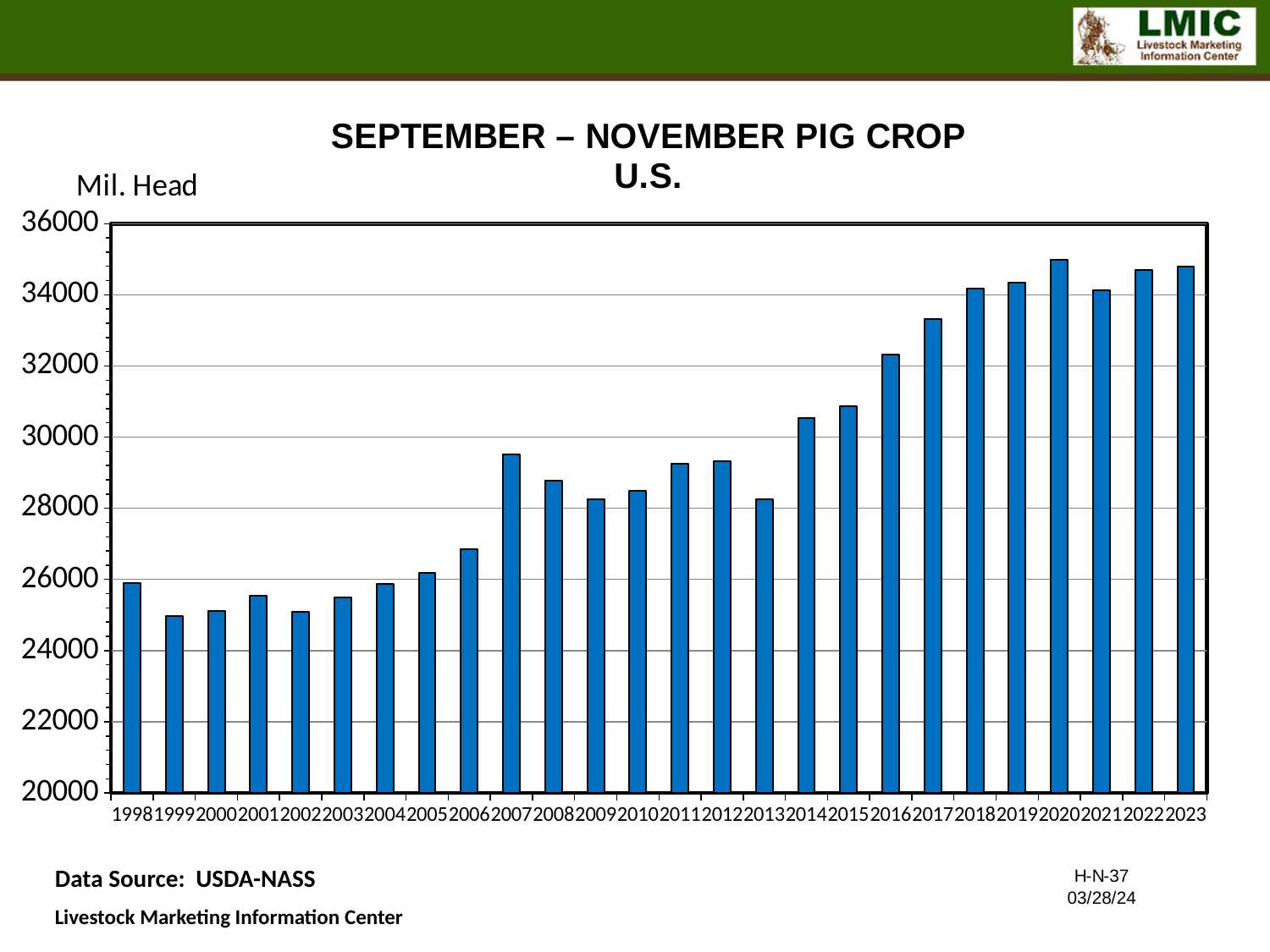
Is the value for 2006 greater or less than 26000? greater What kind of chart is shown on the slide? bar chart Is the value for 2007 greater or less than 30000? less Which year has the highest September–November pig crop in the chart? 2020 Is the value for 2009 greater or less than 30000? less Overall, do the values rise or fall from 1998 to 2023? rise Which is larger, the value for 2007 or the value for 2008? 2007 How many years (bars) are plotted in the chart? 26 What unit is shown on the vertical axis label of the chart? Mil. Head Which is larger, the value for 2011 or the value for 2013? 2011